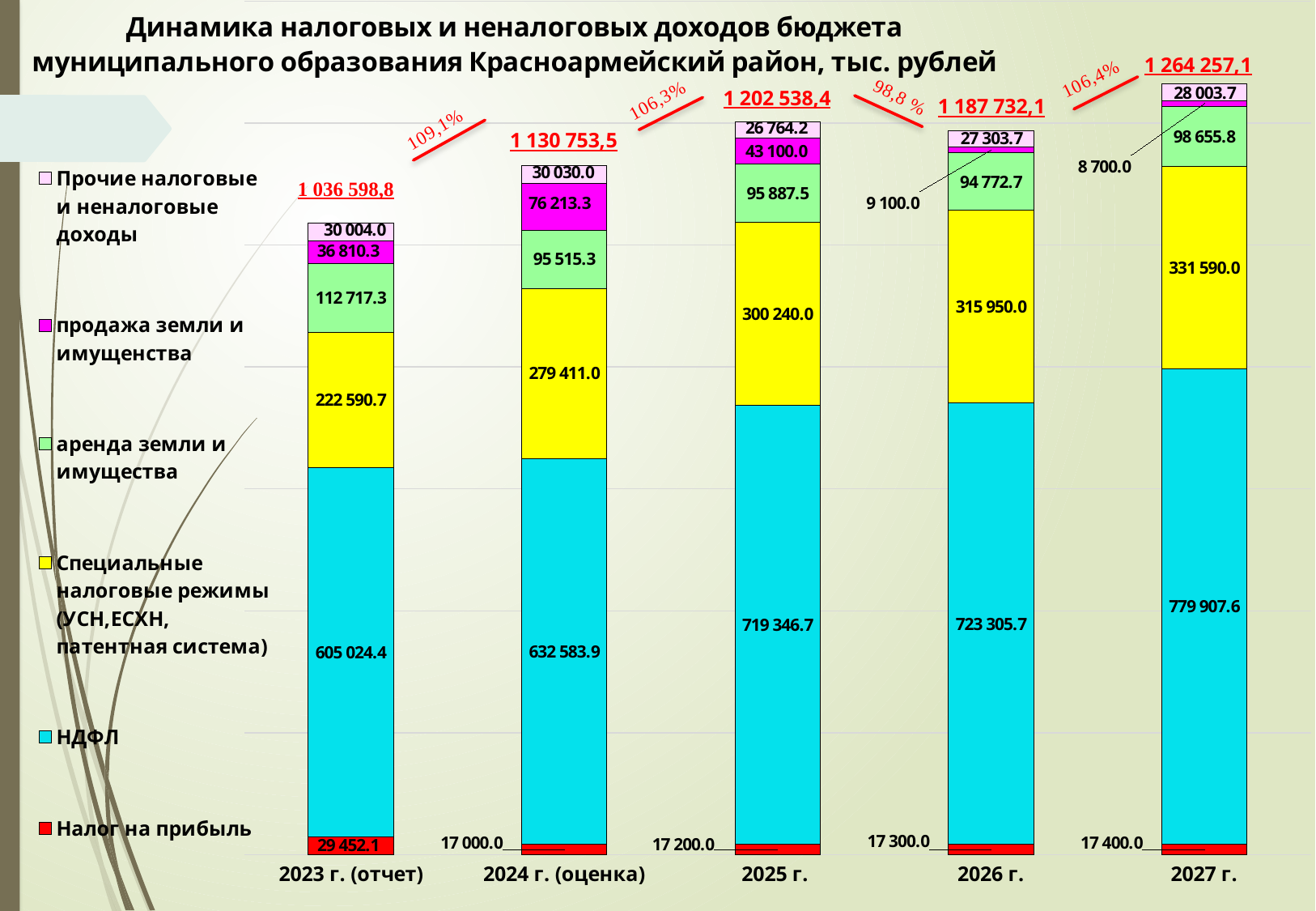
What is the value of Налог на прибыль for 2023 г. (отчет)? 29 452.1 Which is larger: аренда земли и имущества in 2023 г. (отчет) or in 2027 г.? 2023 г. (отчет) What is the difference between НДФЛ in 2027 г. and in 2023 г. (отчет)? 174 883.2 How many series does the legend list? 6 Does НДФЛ rise or fall from 2023 г. to 2027 г.? rise What kind of chart is shown on the slide? stacked bar chart In which year is продажа земли и имущенства the lowest? 2027 г. What is the value of НДФЛ for 2025 г.? 719 346.7 What is the value of продажа земли и имущенства for 2024 г. (оценка)? 76 213.3 How many years (categories) are shown on the x axis? 5 In which year is НДФЛ the highest? 2027 г. What is the total of the stacked bar for 2025 г.? 1 202 538,4